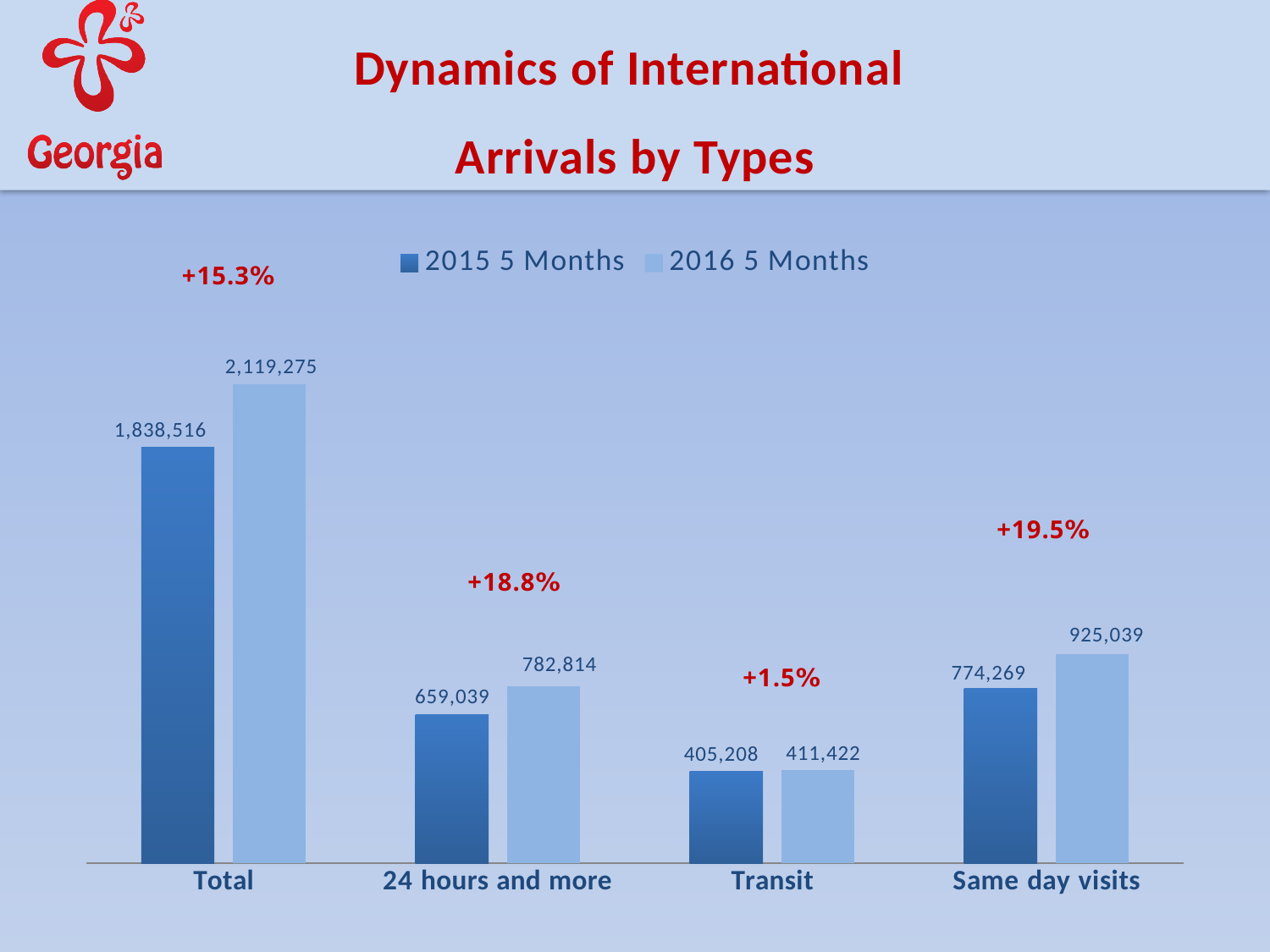
What is the difference between the 2016 5 Months and 2015 5 Months values for Total? 280,759 What type of chart is shown on the slide? Bar chart What is the value for 24 hours and more in 2015 5 Months? 659,039 What is the value for Transit in 2015 5 Months? 405,208 How many series does the legend list? 2 What is the value for Same day visits in 2016 5 Months? 925,039 Which is larger for 2015 5 Months: 24 hours and more or Same day visits? Same day visits Excluding Total, which category has the lowest value in 2016 5 Months? Transit What is the difference between the 2016 5 Months and 2015 5 Months values for Same day visits? 150,770 How many categories are shown on the x axis? 4 What percentage change is shown above the Transit bars? +1.5% What is the value for Total in 2016 5 Months? 2,119,275